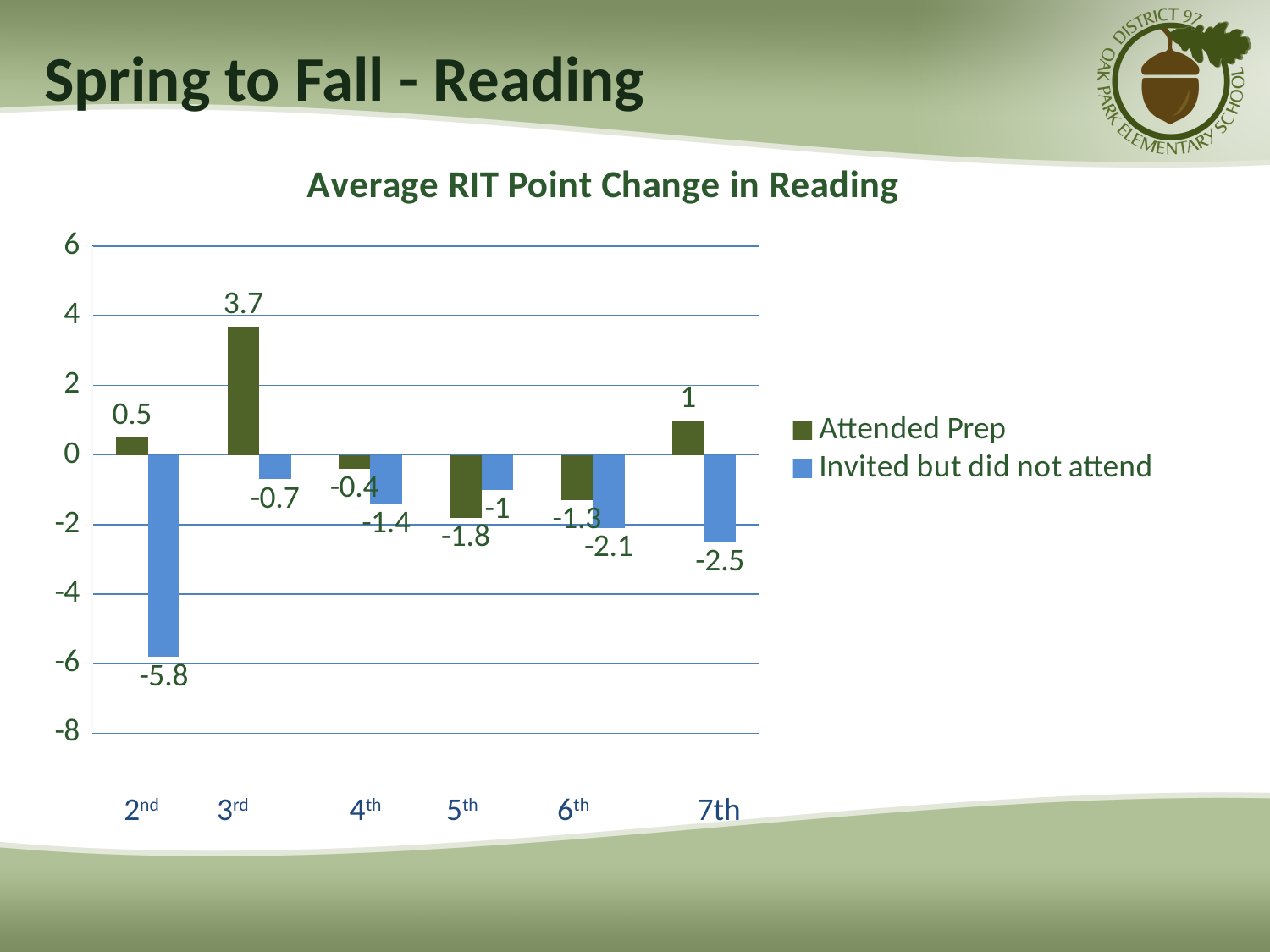
How many grade categories are shown on the x axis? 6 Which grade has the highest Attended Prep value? 3rd What is the Attended Prep value for 3rd grade? 3.7 What is the difference between the Attended Prep and Invited but did not attend values for 2nd grade? 6.3 For 5th grade, which is larger: the Attended Prep value or the Invited but did not attend value? Invited but did not attend What kind of chart is shown on the slide? Bar chart Which grade has the lowest Invited but did not attend value? 2nd What is the Invited but did not attend value for 2nd grade? -5.8 How many series does the legend list? 2 What is the Attended Prep value for 7th grade? 1 What is the title of the chart? Average RIT Point Change in Reading What is the Invited but did not attend value for 6th grade? -2.1